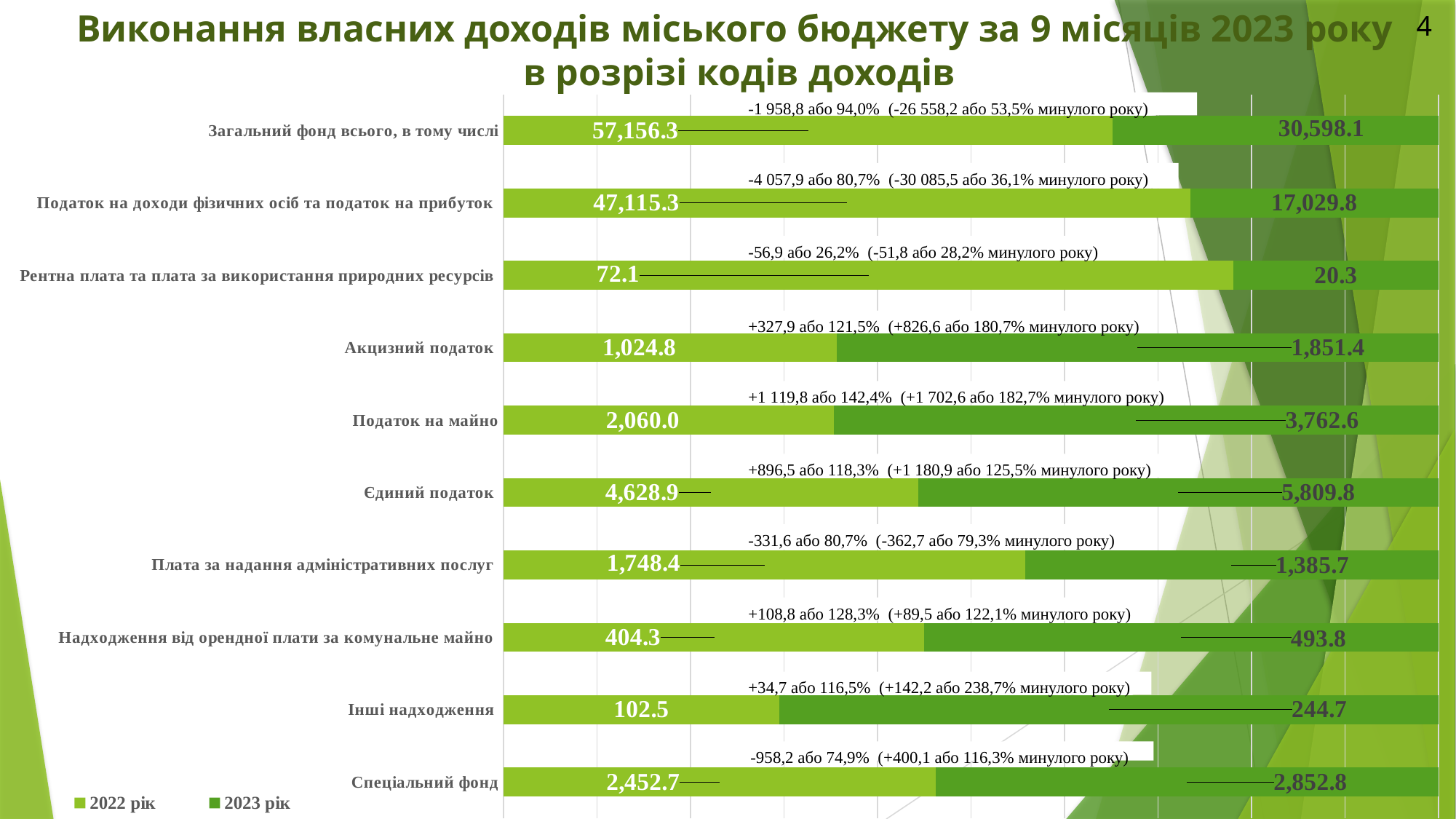
How many categories are plotted on the chart? 10 What is the 2023 рік value for Спеціальний фонд? 2,852.8 Which category has the lowest 2023 рік value? Рентна плата та плата за використання природних ресурсів Which legend entry is shown in the darker green colour? 2023 рік What is the 2022 рік value for Єдиний податок? 4,628.9 How many series does the legend list? 2 For Плата за надання адміністративних послуг, which is larger: the 2022 рік value or the 2023 рік value? 2022 рік What is the difference between the 2023 рік and 2022 рік values for Податок на майно? 1,702.6 What is the 2022 рік value for Інші надходження? 102.5 What is the 2023 рік value for Акцизний податок? 1,851.4 Which category has the highest 2022 рік value? Загальний фонд всього, в тому числі What kind of chart is shown on the slide? bar chart